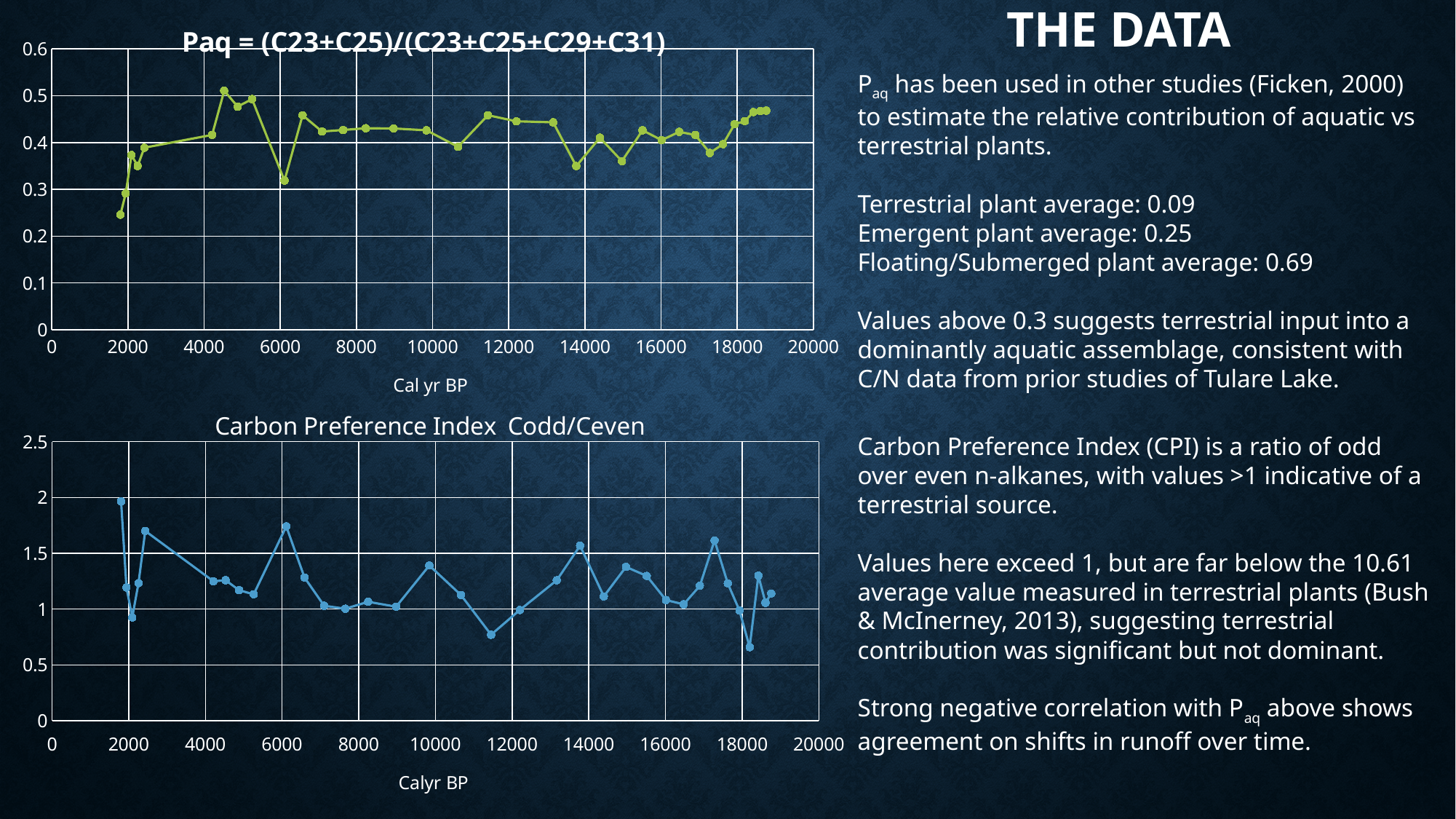
What kind of chart is the bottom chart titled "Carbon Preference Index Codd/Ceven"? line chart What is the title of the bottom chart? Carbon Preference Index Codd/Ceven In the top Paq chart, is the highest value (near 4500 Cal yr BP) greater or less than 0.4? greater In the top Paq chart, do the values generally rise or fall from the first point to the last point along the x axis? rise In the bottom Carbon Preference Index chart, is the lowest value (near 18000 Calyr BP) greater or less than 1? less In the bottom Carbon Preference Index chart, is the peak near 6000 Calyr BP greater or less than 1.5? greater In the bottom Carbon Preference Index chart, do the values generally rise or fall from the first point to the last point along the x axis? fall What is the x-axis label of the top Paq chart? Cal yr BP What kind of chart is the top chart titled "Paq = (C23+C25)/(C23+C25+C29+C31)"? line chart